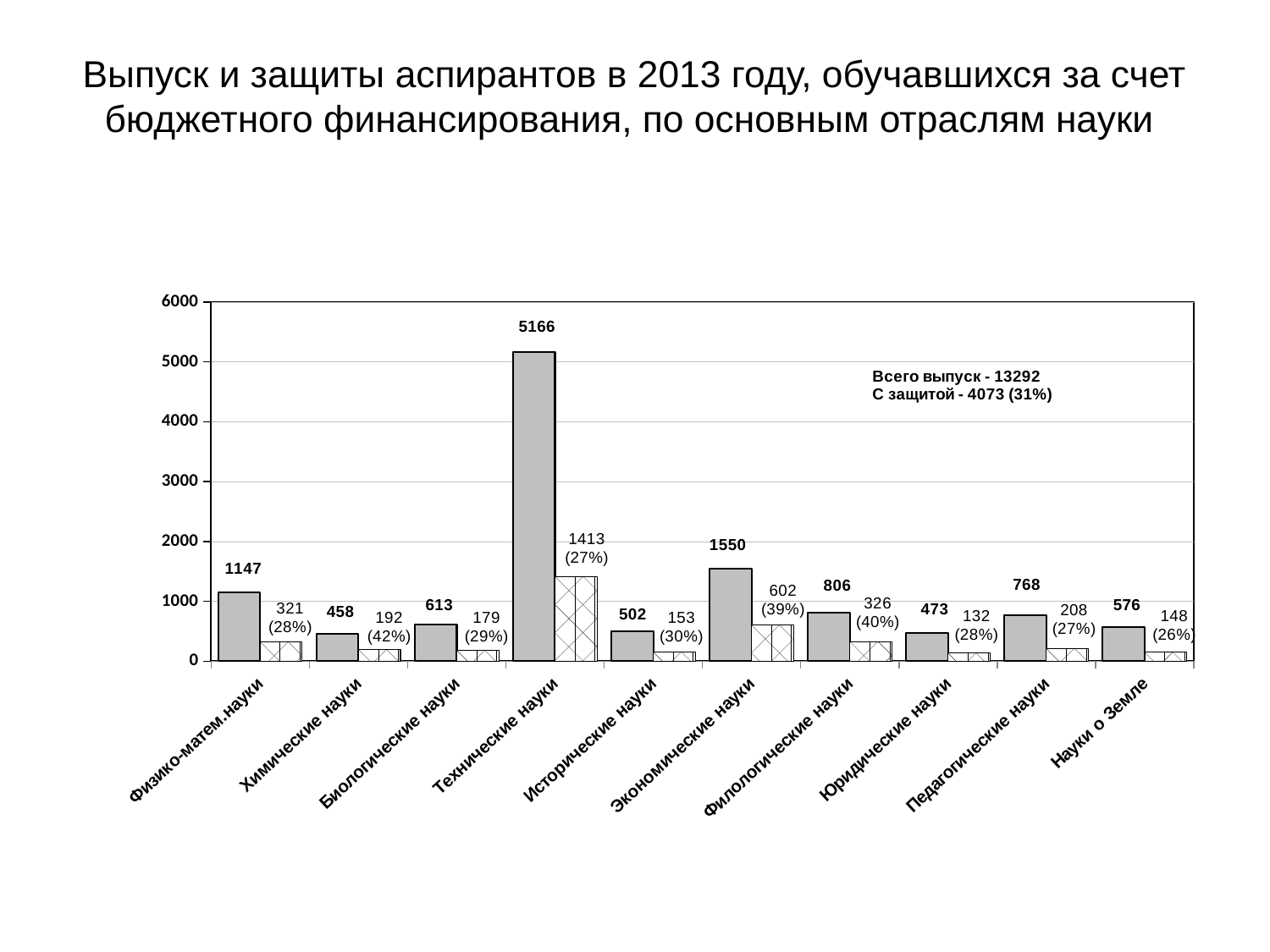
Which category has the lowest graduate (solid bar) value? Химические науки How many categories (fields of science) are shown on the x axis? 10 What percentage of defenses is shown for Филологические науки? 40% What is the value of the solid bar for Физико-матем.науки? 1147 What is the number of defenses (hatched bar) for Экономические науки? 602 (39%) Which category has the highest graduate (solid bar) value? Технические науки What kind of chart is shown on the slide? bar chart Is the solid bar for Экономические науки greater or less than 1000? greater Which is larger: the solid bar for Филологические науки or the solid bar for Педагогические науки? Филологические науки What is the difference between the graduate value for Технические науки and the graduate value for Экономические науки? 3616 What is the number of graduates (solid bar) for Технические науки? 5166 What total number of graduates (Всего выпуск) is stated in the chart annotation? 13292